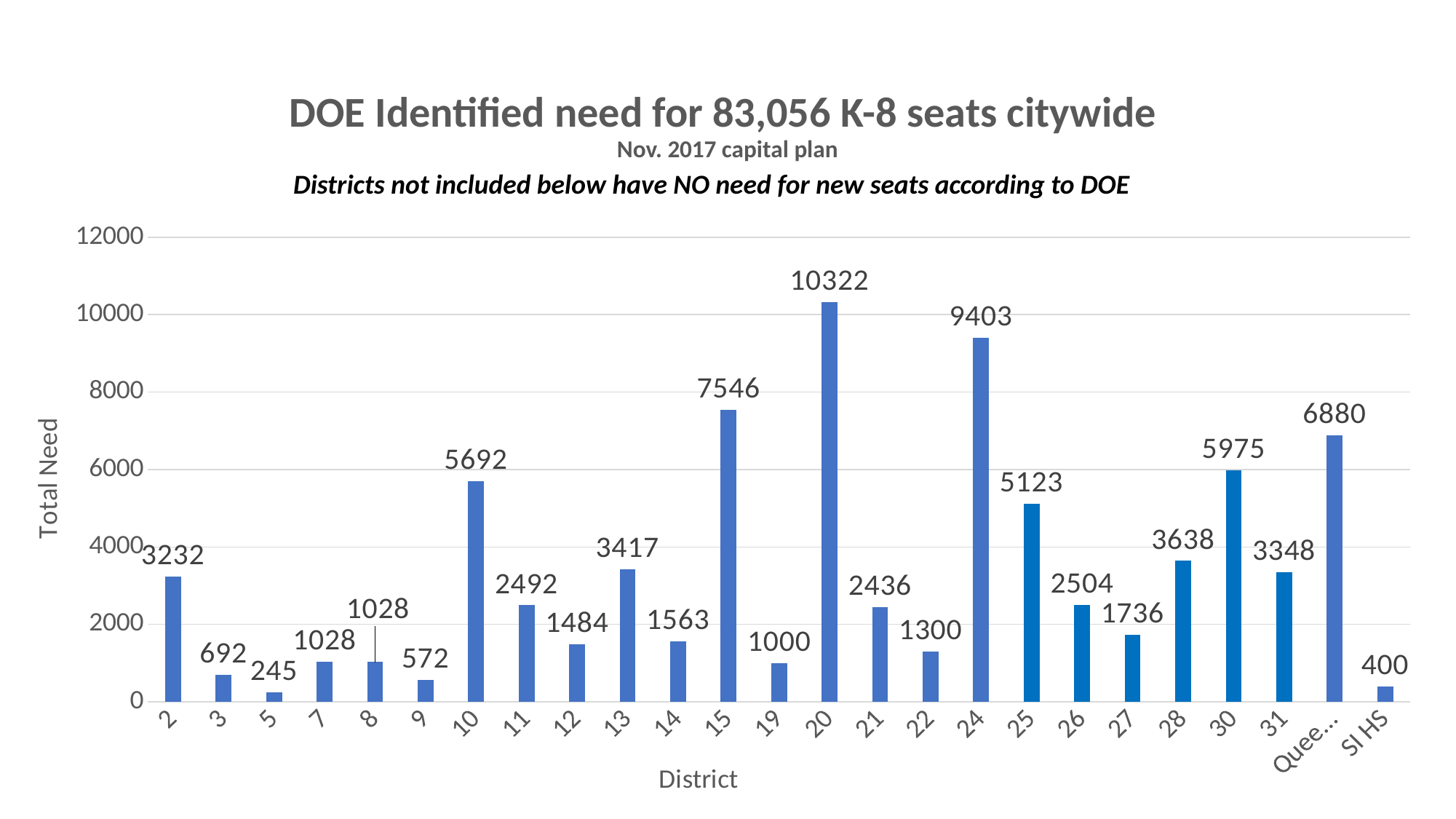
What is the label of the y axis? Total Need What is the total need for district 31? 3348 What is the total need for district 20? 10322 Which has a larger total need, district 25 or district 30? district 30 How many districts are shown on the x axis? 25 What is the total need for SI HS? 400 What is the difference in total need between district 15 and district 10? 1854 Which district has the lowest total need? 5 Which district has the highest total need? 20 What kind of chart is shown on the slide? bar chart What is the difference in total need between district 20 and district 24? 919 What is the total need for district 15? 7546